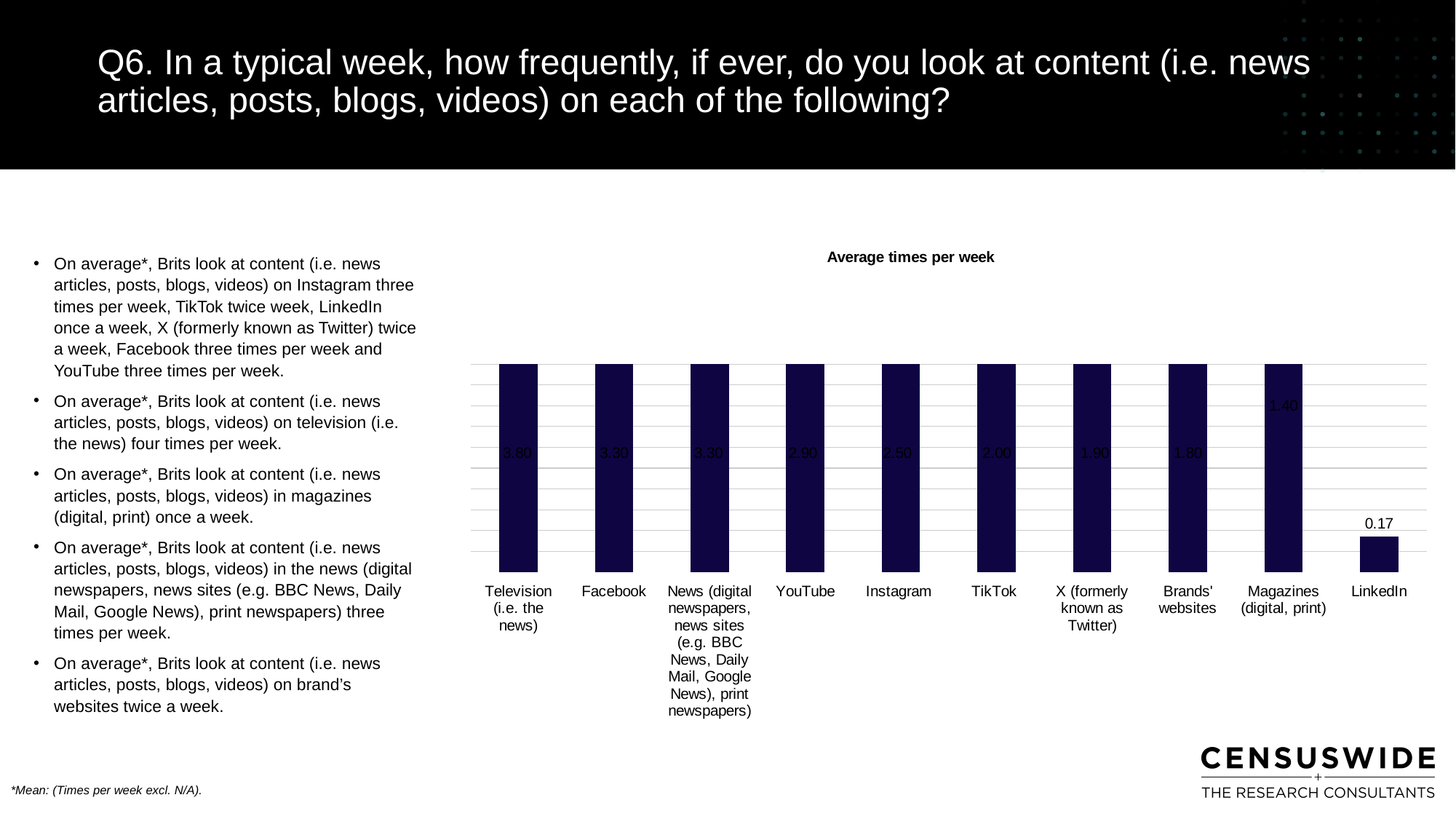
What is the value shown for Instagram? 2.50 What kind of chart is shown on the slide? Bar chart What is the difference between the values for Television (i.e. the news) and LinkedIn? 3.63 How many categories are plotted in the chart? 10 What is the value shown for Magazines (digital, print)? 1.40 Which has a higher value, YouTube or Brands' websites? YouTube Which category has the lowest average times per week? LinkedIn What is the difference between the values for Instagram and TikTok? 0.50 What is the average times per week value for Television (i.e. the news)? 3.80 What is the title of the chart? Average times per week Which category has the highest average times per week? Television (i.e. the news) What is the value shown for LinkedIn? 0.17